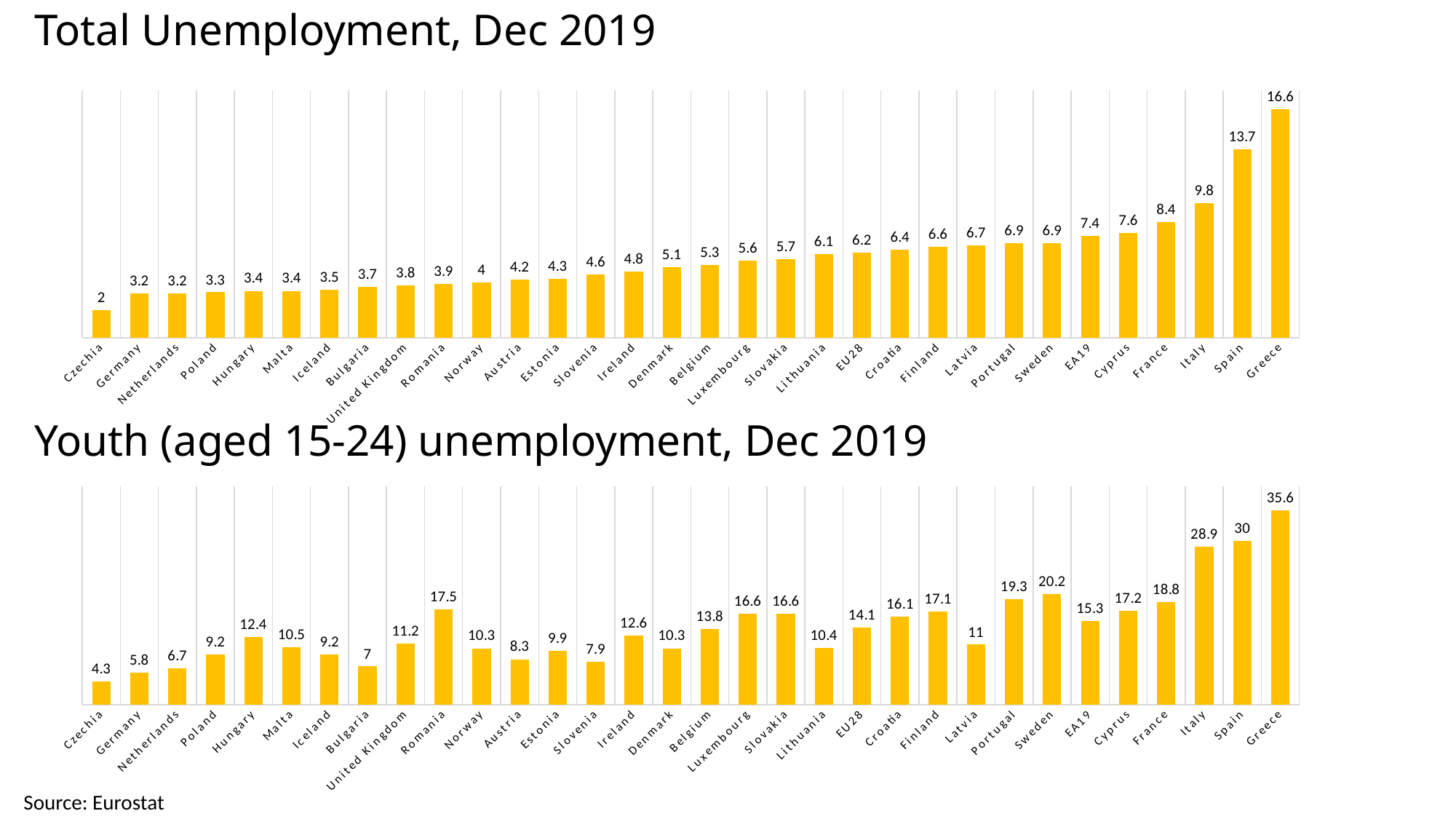
In the 'Total Unemployment, Dec 2019' chart, which country has the highest value? Greece In the 'Youth (aged 15-24) unemployment, Dec 2019' chart, what is the value for Romania? 17.5 In the 'Total Unemployment, Dec 2019' chart, which country has the lowest value? Czechia What source is cited at the bottom of the slide? Eurostat In the 'Youth (aged 15-24) unemployment, Dec 2019' chart, which is larger, Sweden or Portugal? Sweden How many countries or regions are shown in the 'Total Unemployment, Dec 2019' chart? 32 In the 'Total Unemployment, Dec 2019' chart, what is the difference between Spain and Italy? 3.9 In the 'Total Unemployment, Dec 2019' chart, what is the value for Germany? 3.2 In the 'Total Unemployment, Dec 2019' chart, what is the value for EU28? 6.2 In the 'Youth (aged 15-24) unemployment, Dec 2019' chart, what is the difference between Greece and Spain? 5.6 What type of chart is the 'Youth (aged 15-24) unemployment, Dec 2019' chart? Bar chart In the 'Youth (aged 15-24) unemployment, Dec 2019' chart, which country has the highest value? Greece